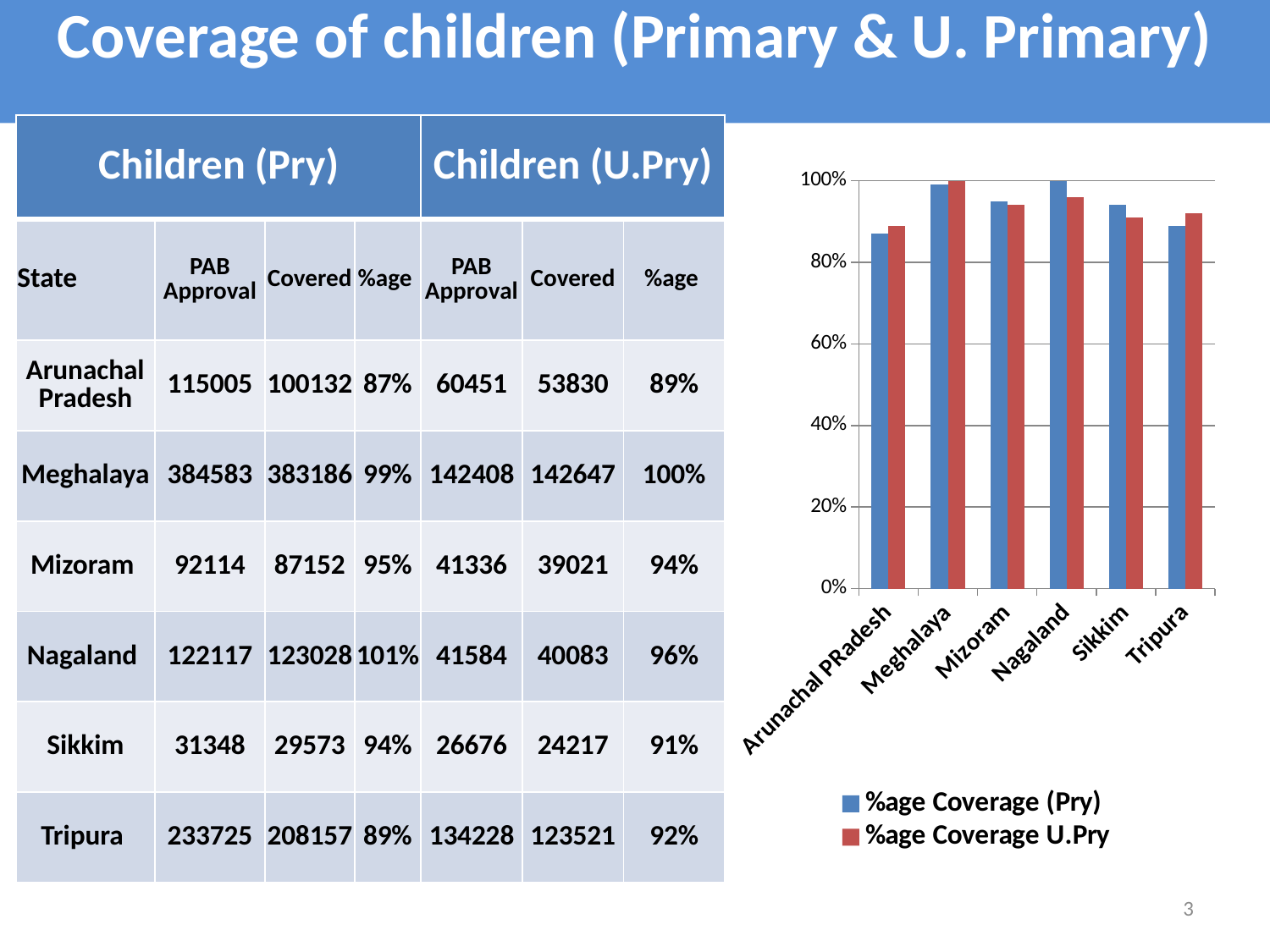
What is the %age Coverage U.Pry for Tripura, as given in the table on the slide? 92% Is the %age Coverage (Pry) value for Arunachal Pradesh greater or less than 80%? greater For Nagaland, which is larger: %age Coverage (Pry) or %age Coverage U.Pry? %age Coverage (Pry) What is the %age Coverage (Pry) for Mizoram, as given in the table on the slide? 95% Which state has the highest %age Coverage U.Pry in the chart? Meghalaya What are the two legend entries of the chart? %age Coverage (Pry) and %age Coverage U.Pry Is the %age Coverage U.Pry value for Sikkim greater or less than 80%? greater Which is larger: the %age Coverage (Pry) for Meghalaya or for Arunachal Pradesh? Meghalaya What kind of chart is shown on the slide? bar chart How many series does the chart legend list? 2 Is the %age Coverage (Pry) value for Mizoram greater or less than 100%? less How many states are plotted on the x axis of the chart? 6